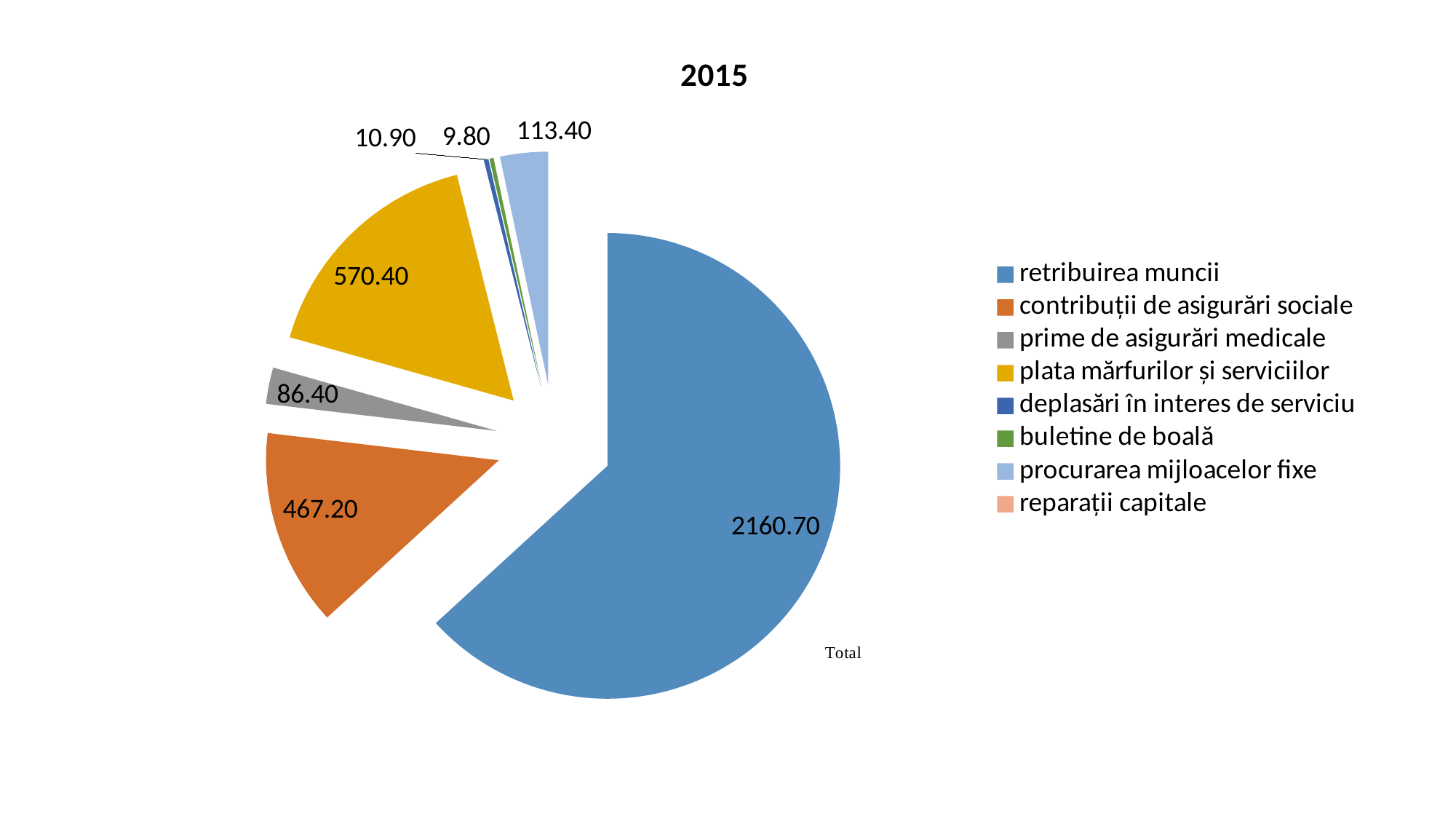
Which category has the largest slice of the pie? retribuirea muncii Which is larger, deplasări în interes de serviciu or buletine de boală? deplasări în interes de serviciu What is the value for plata mărfurilor și serviciilor? 570.40 What is the difference between procurarea mijloacelor fixe and prime de asigurări medicale? 27.00 How many categories does the legend list? 8 What is the difference between plata mărfurilor și serviciilor and contribuții de asigurări sociale? 103.20 What is the value for contribuții de asigurări sociale? 467.20 What is the title of the chart? 2015 What is the value for procurarea mijloacelor fixe? 113.40 What type of chart is shown on the slide? pie chart What is the value for retribuirea muncii? 2160.70 What is the value for prime de asigurări medicale? 86.40